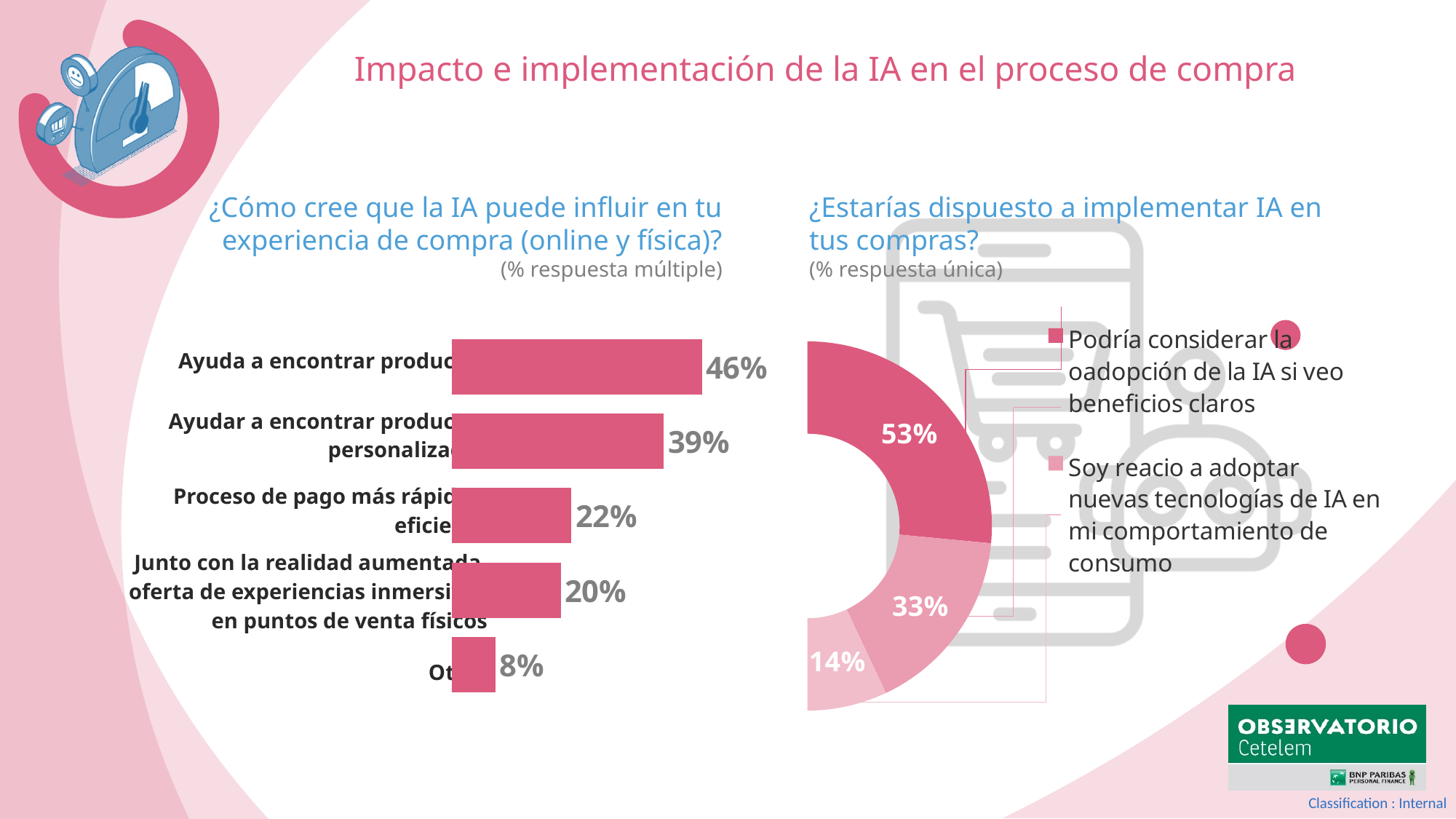
In the bar chart on the left, how many bars are plotted? 5 In the bar chart on the left, which category has the highest value? Ayuda a encontrar produc... (the top bar) In the bar chart on the left, what is the difference between the top bar (46%) and the second bar (39%)? 7% In the bar chart on the left, what is the value for the category 'Junto con la realidad aumentada... en puntos de venta físicos'? 20% In the bar chart on the left, what is the value for the category beginning 'Proceso de pago más rápid...'? 22% In the bar chart on the left, what is the value of the bottom bar? 8% In the donut chart on the right, what share corresponds to 'Podría considerar la adopción de la IA si veo beneficios claros'? 53% How many entries does the legend of the donut chart on the right list? 2 In the donut chart on the right, what share corresponds to 'Soy reacio a adoptar nuevas tecnologías de IA en mi comportamiento de consumo'? 33% What type of chart is shown on the left side of the slide? Bar chart In the donut chart on the right, what is the smallest slice value shown? 14% In the bar chart on the left, what is the value for the top category, 'Ayuda a encontrar produc...'? 46%